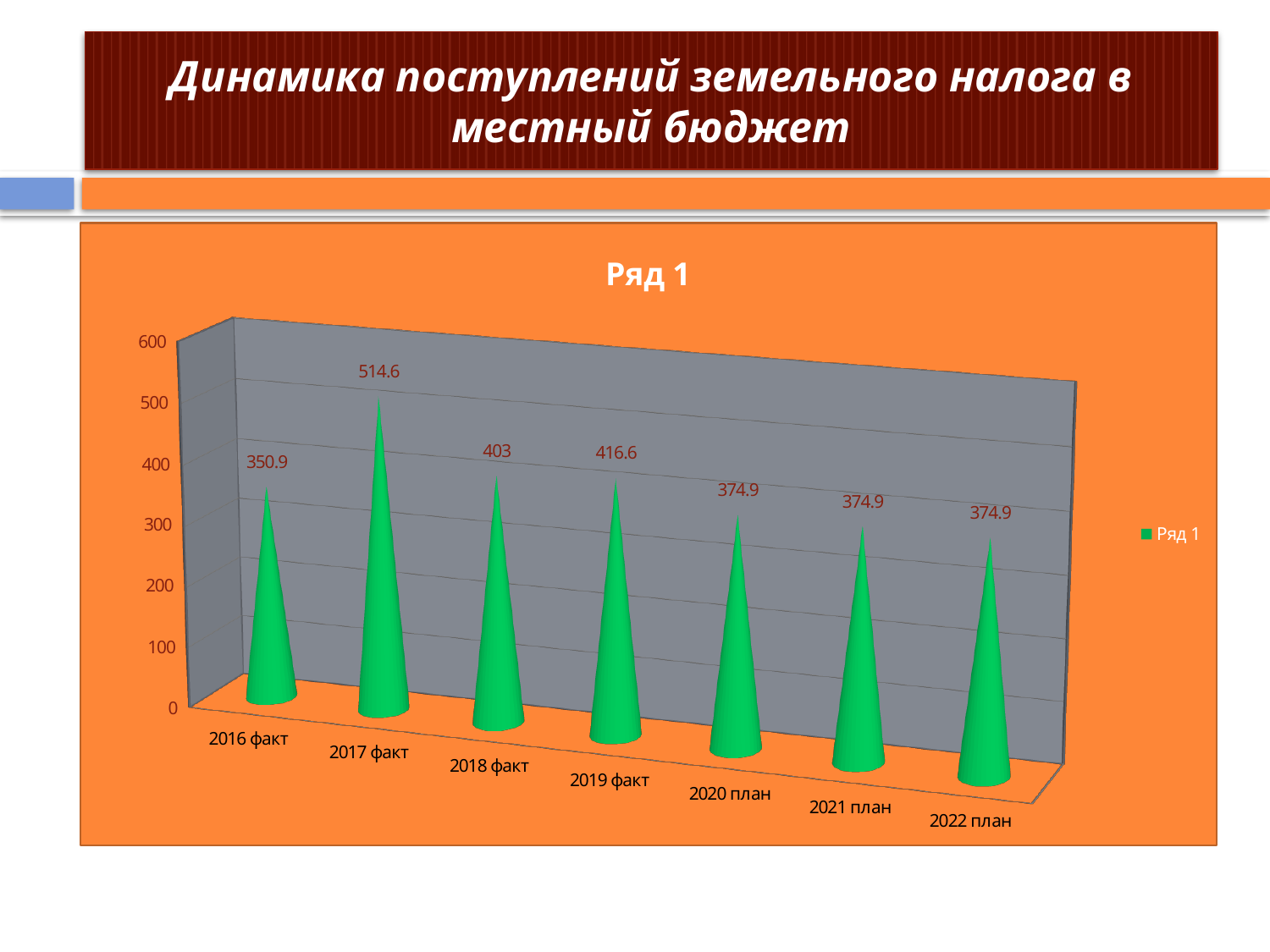
What is the value for 2019 факт? 416.6 What is the value for 2022 план? 374.9 What is the value for 2017 факт? 514.6 Which category has the highest value? 2017 факт What is the title of the chart? Ряд 1 How many categories are shown on the x axis? 7 How many series does the legend list? 1 What is the difference between the values for 2017 факт and 2018 факт? 111.6 What is the value for 2016 факт? 350.9 Which is larger, the value for 2018 факт or the value for 2019 факт? 2019 факт Is the value for 2017 факт greater or less than 500? greater Which category has the lowest value? 2016 факт